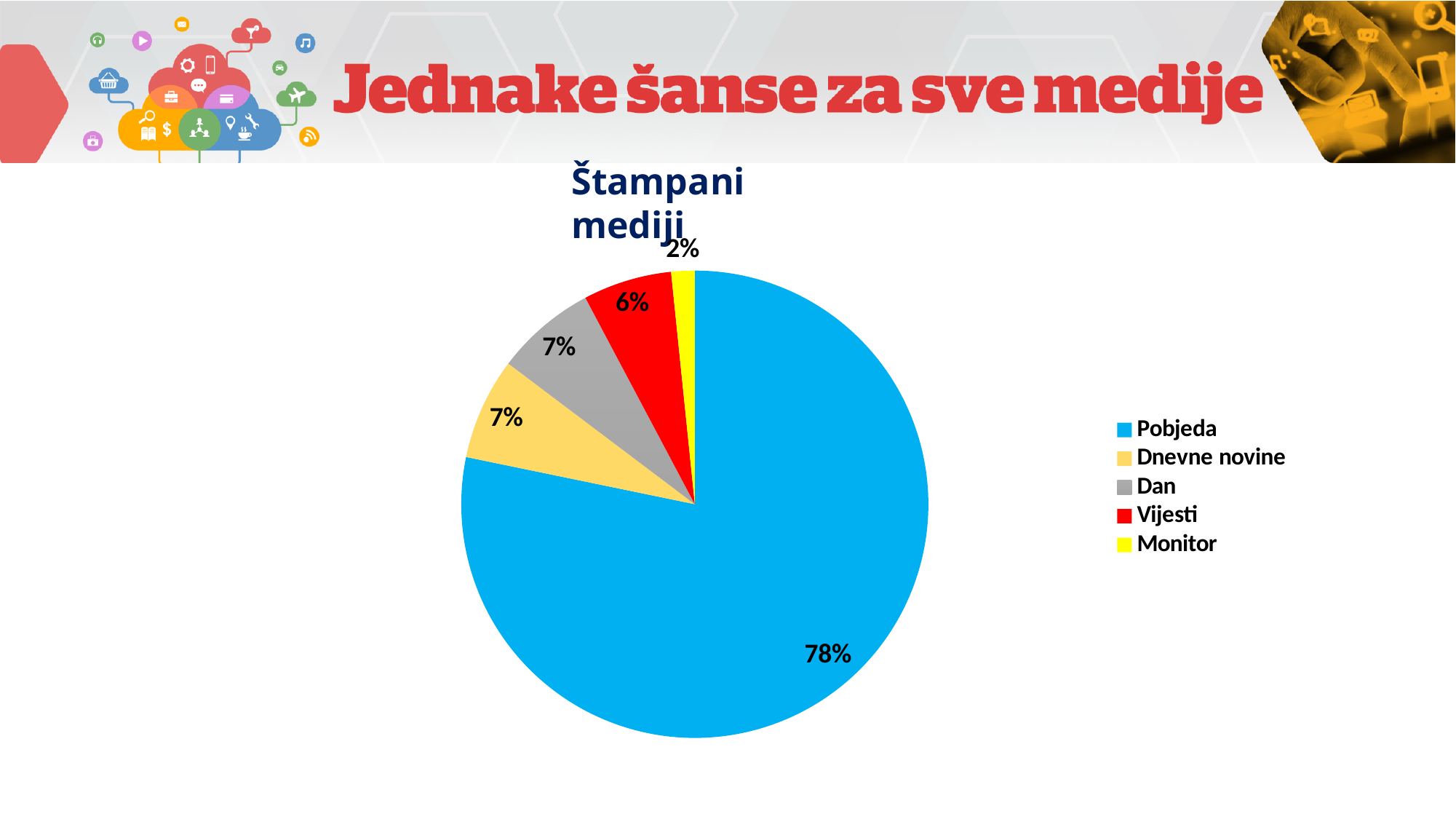
What kind of chart is shown on the slide? Pie chart What share of the pie does Pobjeda have? 78% How many categories does the pie chart show? 5 Which category has the smallest slice of the pie? Monitor What is the title of the chart? Štampani mediji What is the value shown for Vijesti? 6% What is the difference between the values for Pobjeda and Vijesti? 72% What is the value shown for Dan? 7% What is the value shown for Dnevne novine? 7% What is the value shown for Monitor? 2% Which is larger, the value for Vijesti or the value for Monitor? Vijesti Which category has the largest slice of the pie? Pobjeda